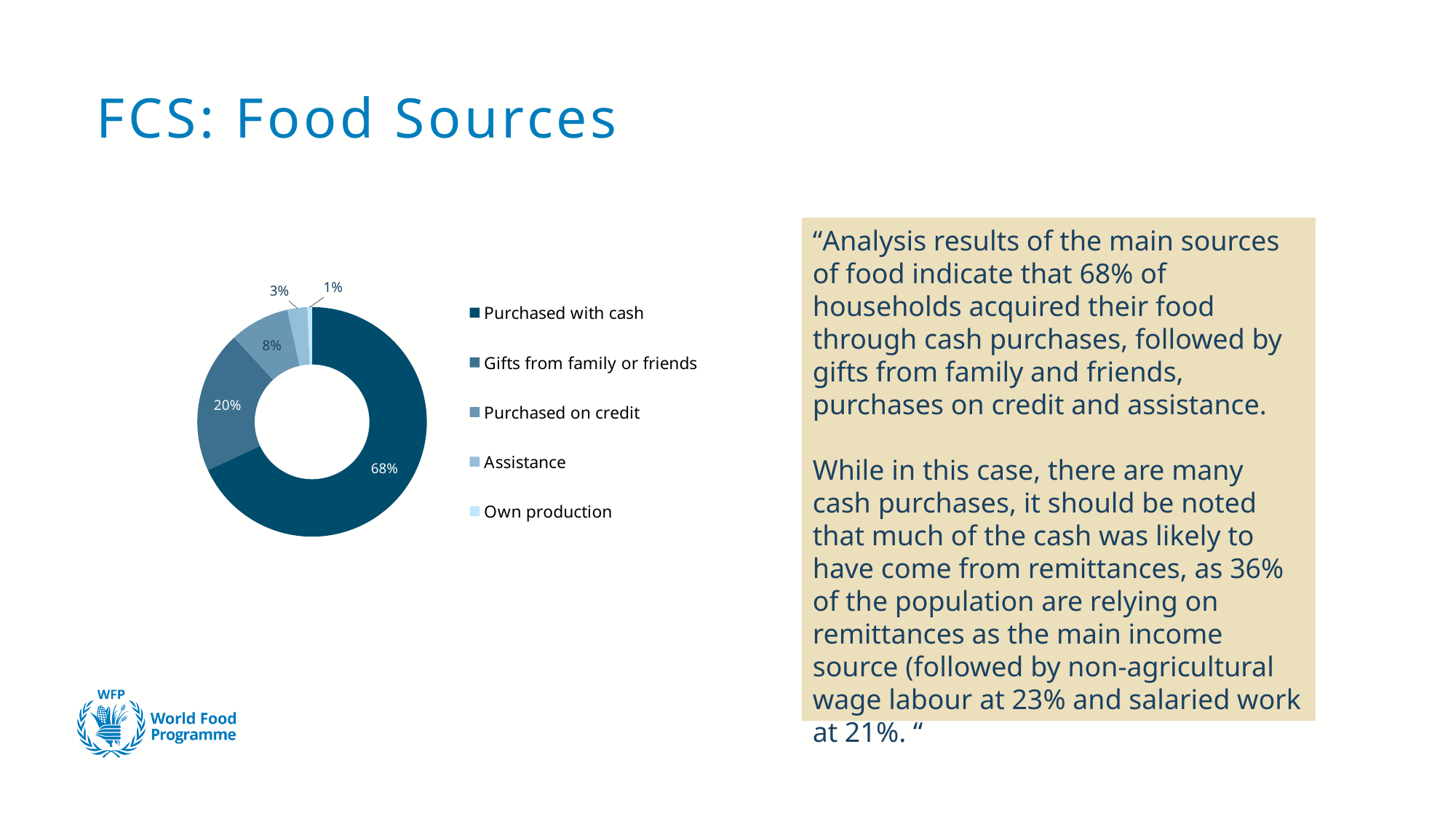
What is the value for own production? 1% What percentage of food comes from gifts from family or friends? 20% Which is larger: purchased on credit or assistance? Purchased on credit What is the value for assistance? 3% What is the value for purchased on credit? 8% What kind of chart is shown on the slide? Doughnut (pie) chart Which food source has the largest share? Purchased with cash What is the difference between the share purchased with cash and the share from gifts from family or friends? 48 percentage points Which food source has the smallest share? Own production How many food source categories does the chart show? 5 Which legend entry is shown in the lightest blue colour? Own production What share of food sources is purchased with cash? 68%